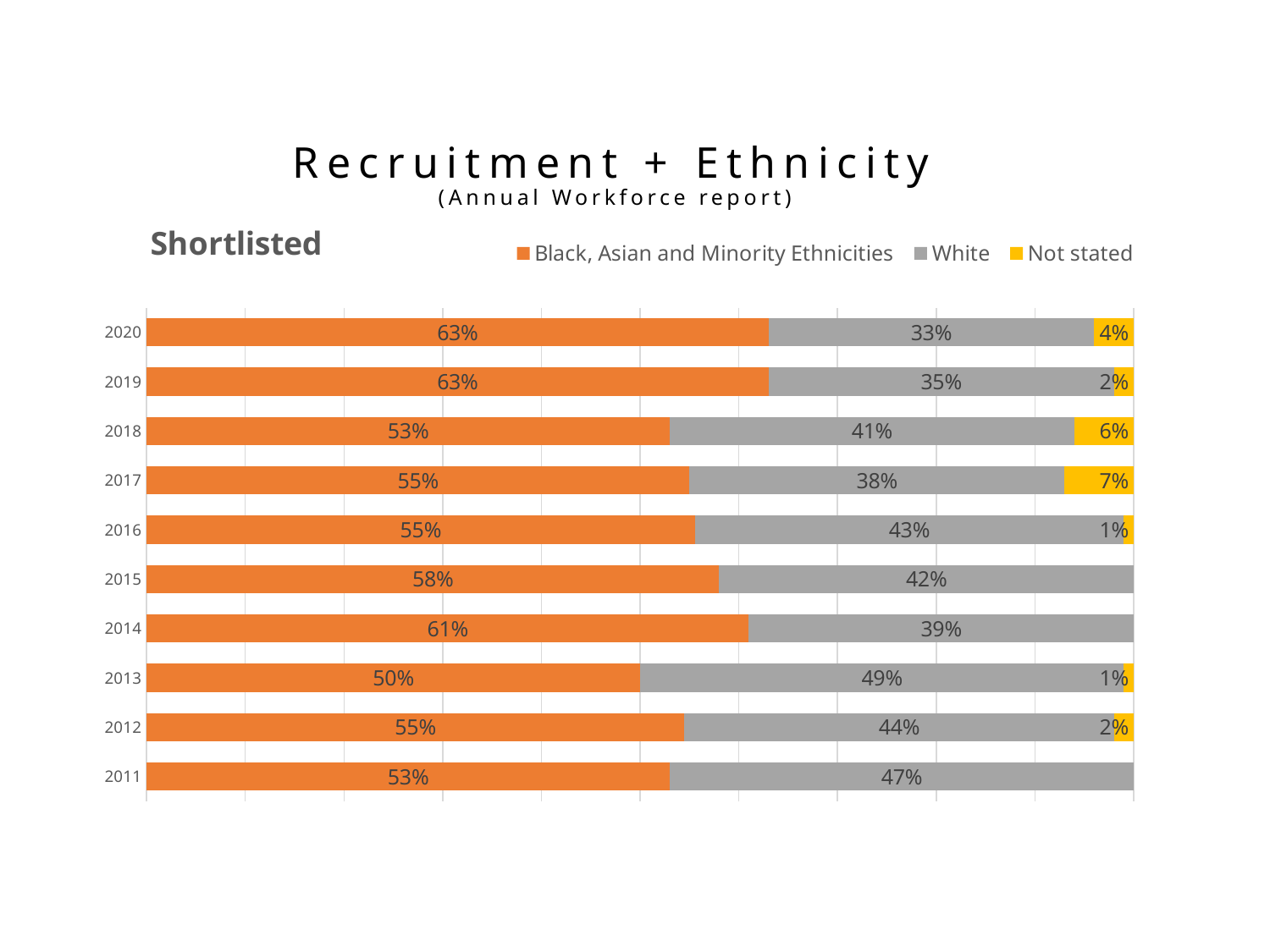
How many years are shown on the chart? 10 Which year has the highest White share of shortlisted candidates? 2013 How many series does the legend list? 3 What kind of chart is shown on the slide? Stacked bar chart In 2013, what is the difference between the Black, Asian and Minority Ethnicities share and the White share? 1% What percentage of shortlisted candidates in 2020 were Black, Asian and Minority Ethnicities? 63% What is the total of the three segments in the 2020 bar? 100% What is the Not stated value for 2017? 7% Which year has the highest Not stated share? 2017 Is the Black, Asian and Minority Ethnicities share larger in 2014 or in 2018? 2014 What is the White share of shortlisted candidates in 2013? 49% Which year has the lowest White share of shortlisted candidates? 2020